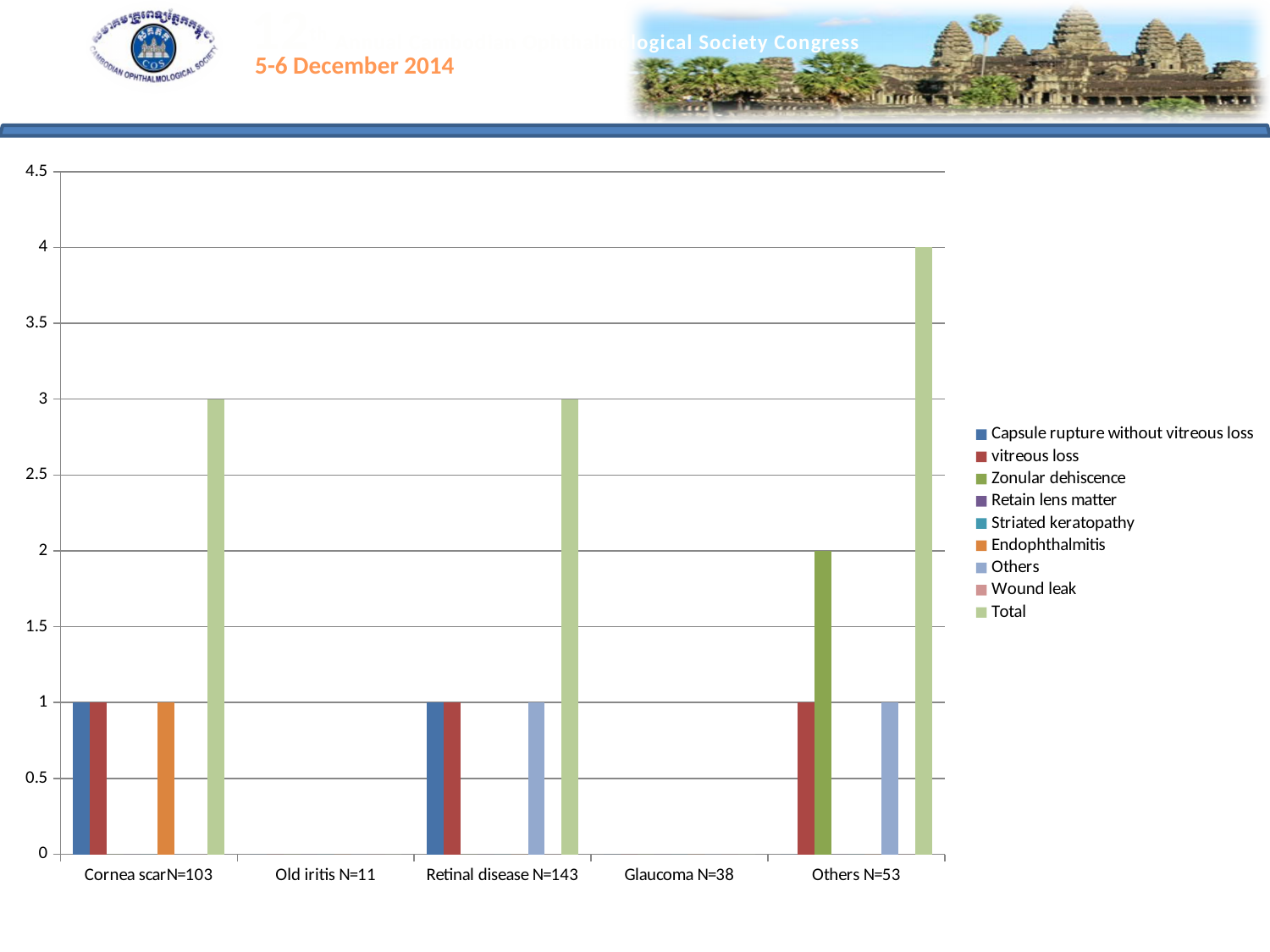
Is the Total value for Others N=53 greater or less than 3.5? greater How many categories are shown on the x axis? 5 What is the Endophthalmitis value for Cornea scarN=103? 1 What is the Zonular dehiscence value for Others N=53? 2 What kind of chart is shown on the slide? bar chart What is the Total value for Cornea scarN=103? 3 What is the difference between the Total for Others N=53 and the Total for Retinal disease N=143? 1 Which category has the highest Total bar? Others N=53 How many series does the legend list? 9 Which is larger, the Zonular dehiscence value for Others N=53 or the vitreous loss value for Others N=53? Zonular dehiscence What is the Total value for Others N=53? 4 Which legend entry is listed last? Total